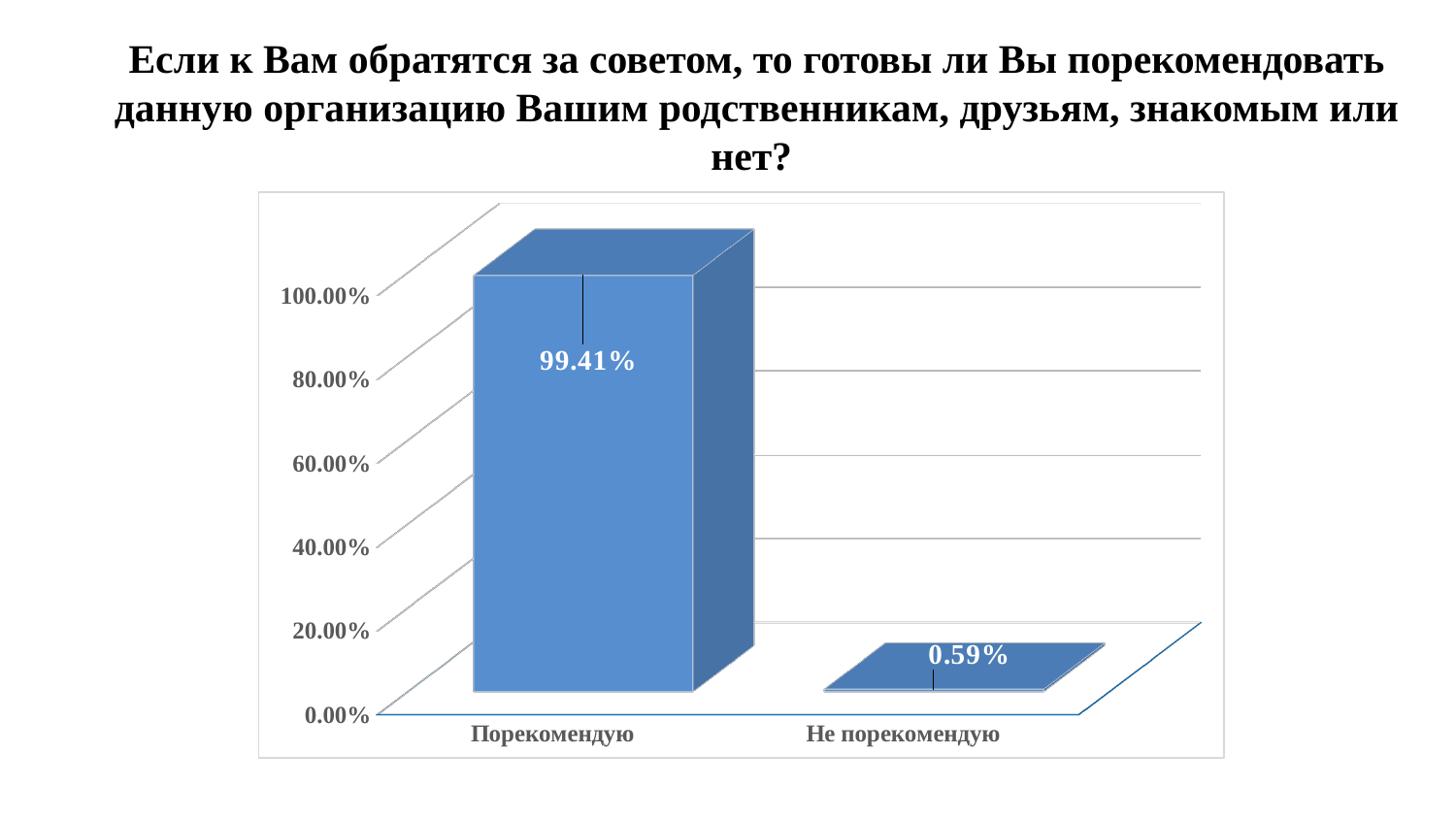
What is the value for "Порекомендую"? 99.41% What is the total of the two values shown on the chart? 100.00% Which category has the lowest value? Не порекомендую What is the difference between the values for "Порекомендую" and "Не порекомендую"? 98.82% What kind of chart is shown on the slide? bar chart What is the highest value shown on the vertical axis? 100.00% Which category has the highest value? Порекомендую Is the value for "Не порекомендую" greater or less than 20.00%? less How many categories are shown on the chart? 2 Is the value for "Порекомендую" greater or less than 80.00%? greater Which is larger, the value for "Порекомендую" or the value for "Не порекомендую"? Порекомендую What is the value for "Не порекомендую"? 0.59%